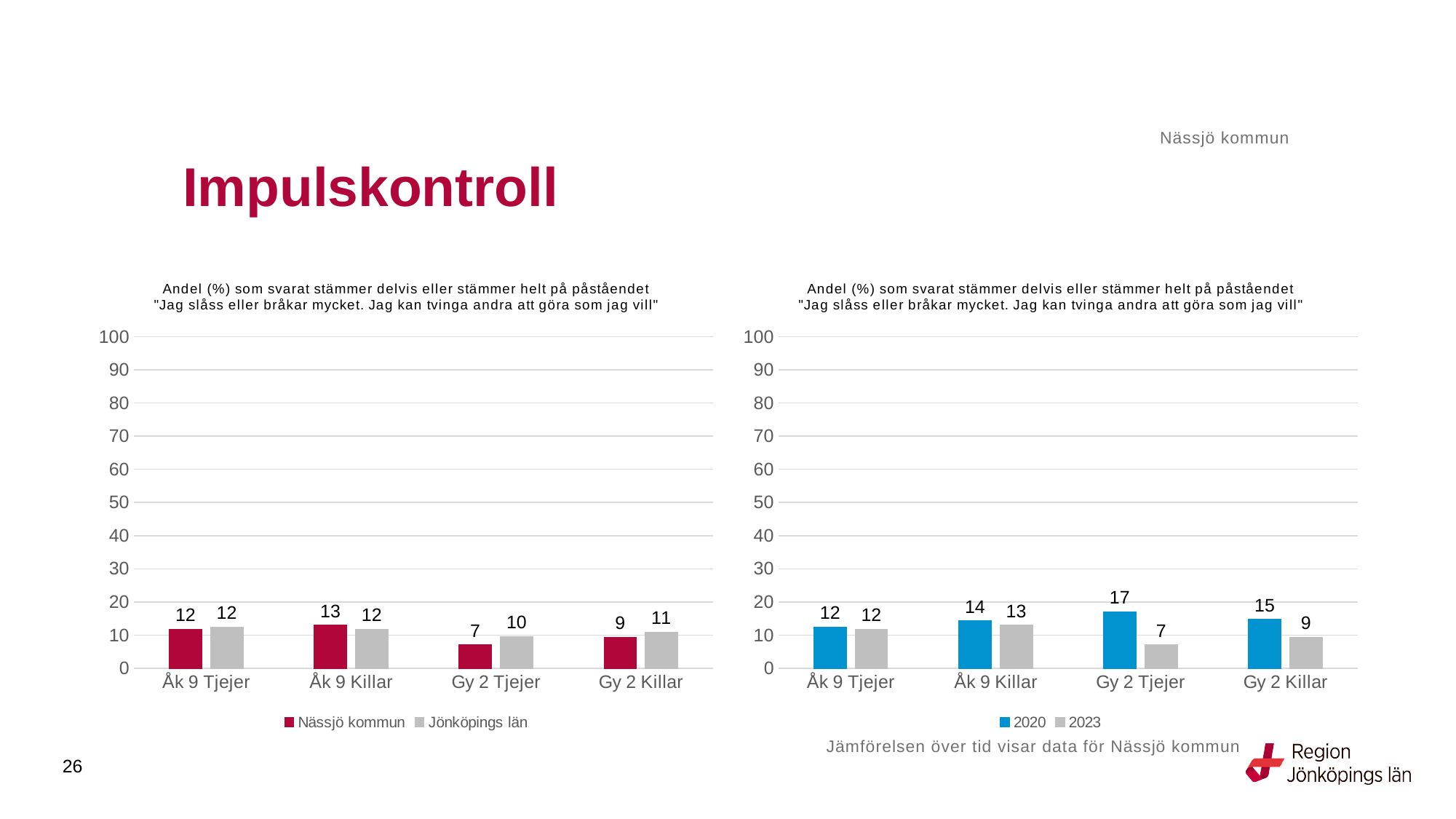
In the left chart, what is the value for Jönköpings län for Gy 2 Killar? 11 What kind of chart is the left chart? Bar chart In the left chart, what is the value for Nässjö kommun for Gy 2 Tjejer? 7 How many series does the legend of the right chart list? 2 In the right chart, is the 2020 value for Gy 2 Killar greater or less than 10? greater In the left chart, which is larger for Gy 2 Killar: Nässjö kommun or Jönköpings län? Jönköpings län How many categories are shown on the x axis of the left chart? 4 In the right chart, what is the difference between the 2020 and 2023 values for Gy 2 Tjejer? 10 In the right chart, what is the 2020 value for Gy 2 Tjejer? 17 In the left chart, which category has the lowest Nässjö kommun value? Gy 2 Tjejer In the right chart, which category has the highest 2020 value? Gy 2 Tjejer In the right chart, what is the 2023 value for Gy 2 Killar? 9